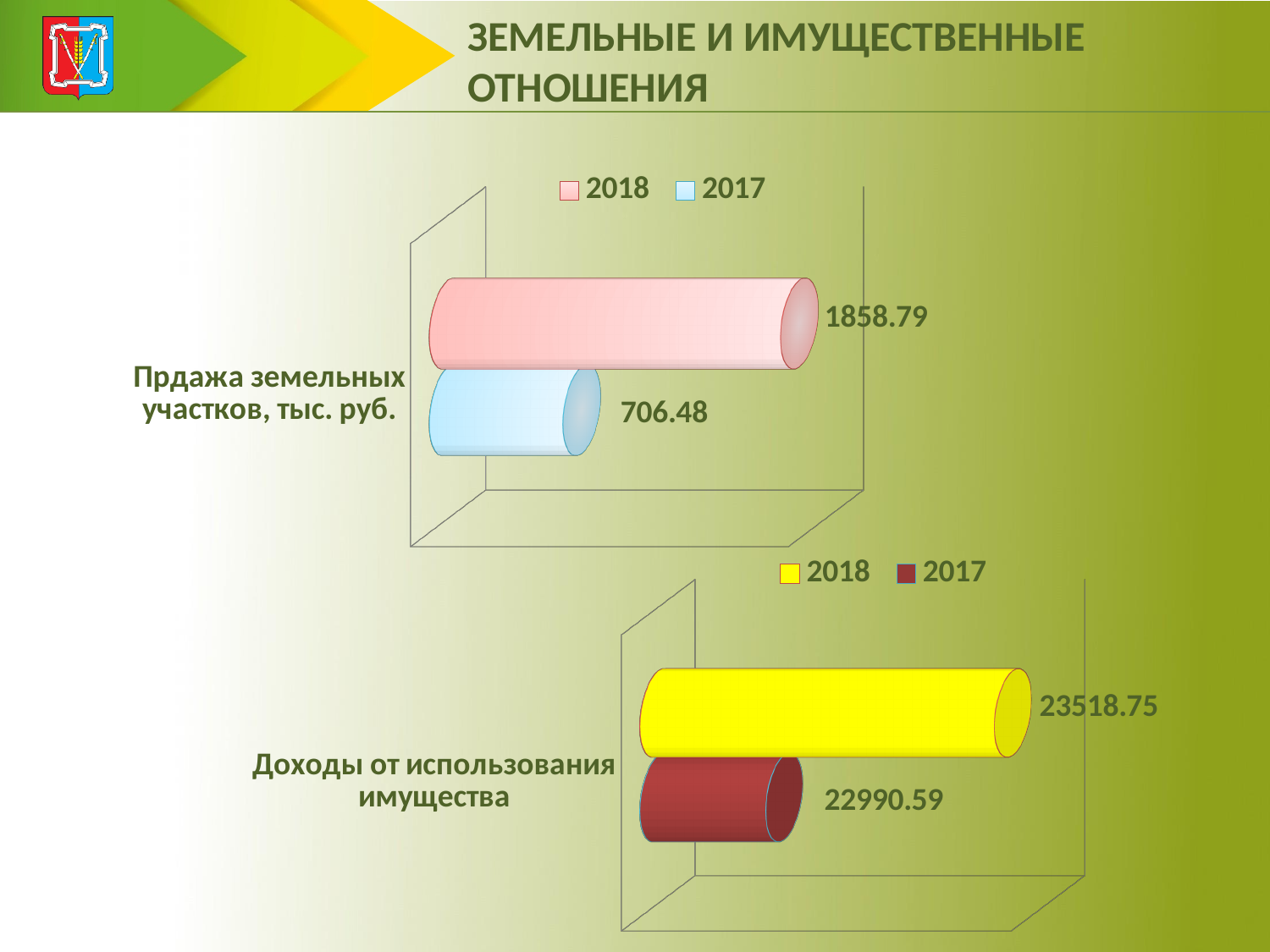
What kind of chart is the bottom chart (Доходы от использования имущества)? bar chart In the bottom chart (Доходы от использования имущества), what colour is the bar for 2018? yellow In the top chart (Прдажа земельных участков, тыс. руб.), what is the value for 2017? 706.48 In the top chart (Прдажа земельных участков, тыс. руб.), what is the value for 2018? 1858.79 In the top chart (Прдажа земельных участков, тыс. руб.), what is the difference between the 2018 and 2017 values? 1152.31 How many series does the legend of the top chart list? 2 In the bottom chart (Доходы от использования имущества), what is the difference between the 2018 and 2017 values? 528.16 In the bottom chart (Доходы от использования имущества), is the 2018 value larger or smaller than the 2017 value? larger In the bottom chart (Доходы от использования имущества), what is the value for 2018? 23518.75 In the bottom chart (Доходы от использования имущества), which year has the lower value? 2017 In the bottom chart (Доходы от использования имущества), what is the value for 2017? 22990.59 In the top chart (Прдажа земельных участков, тыс. руб.), which year has the higher value? 2018